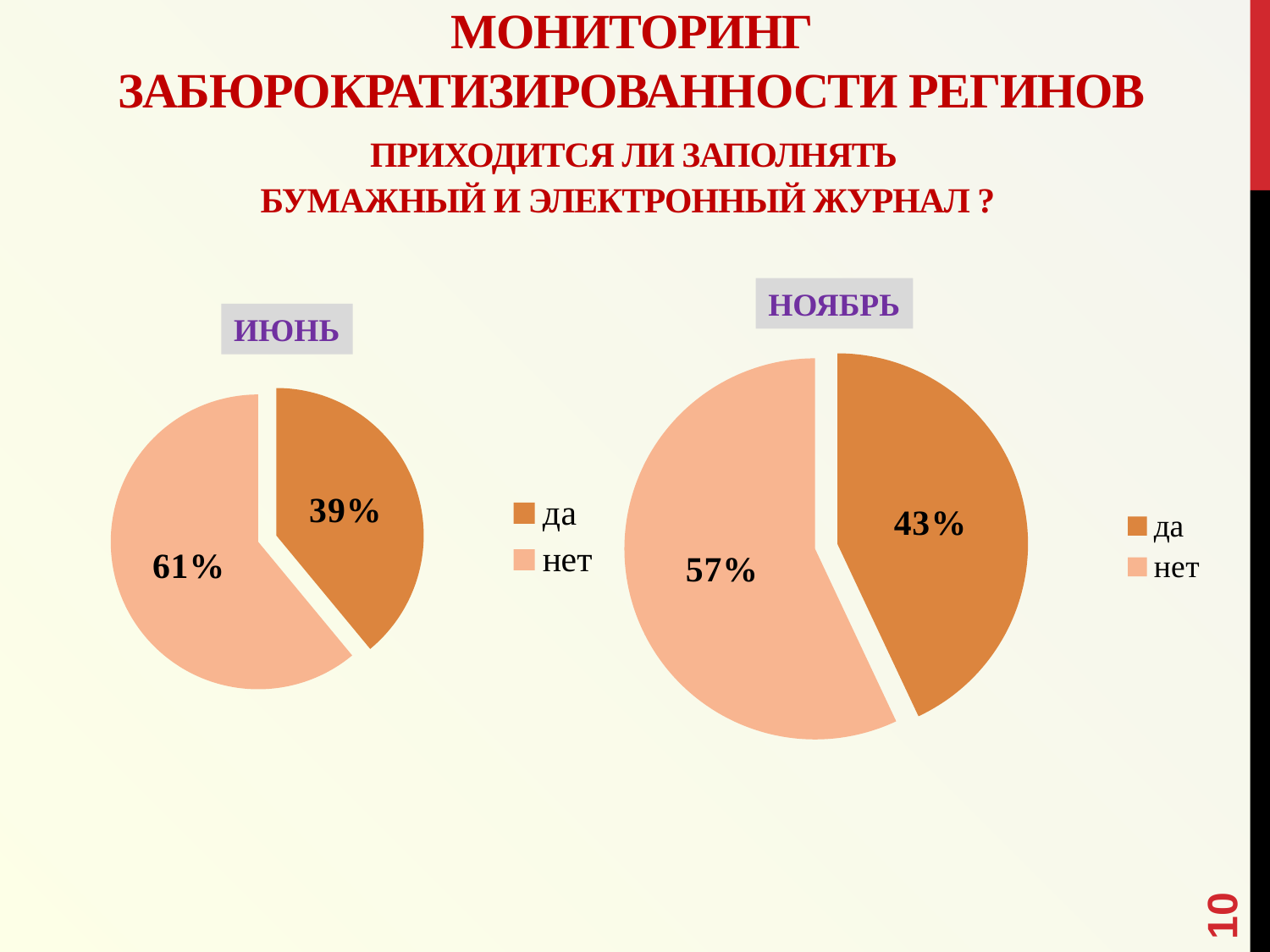
In the НОЯБРЬ pie chart, what share is labelled for "да"? 43% In the ИЮНЬ pie chart, what share is labelled for "да"? 39% Which chart has the larger share for "да", ИЮНЬ or НОЯБРЬ? НОЯБРЬ What kind of chart is the ИЮНЬ chart? Pie chart In the ИЮНЬ pie chart, which slice is the largest? нет In the НОЯБРЬ pie chart, what is the difference between the "нет" and "да" shares? 14% How many slices does the НОЯБРЬ pie chart have? 2 How many entries does the legend of the ИЮНЬ chart list? 2 In the НОЯБРЬ pie chart, which slice is the smallest? да In the ИЮНЬ pie chart, what share is labelled for "нет"? 61% In the ИЮНЬ pie chart, what is the difference between the "нет" and "да" shares? 22% In the НОЯБРЬ pie chart, what share is labelled for "нет"? 57%